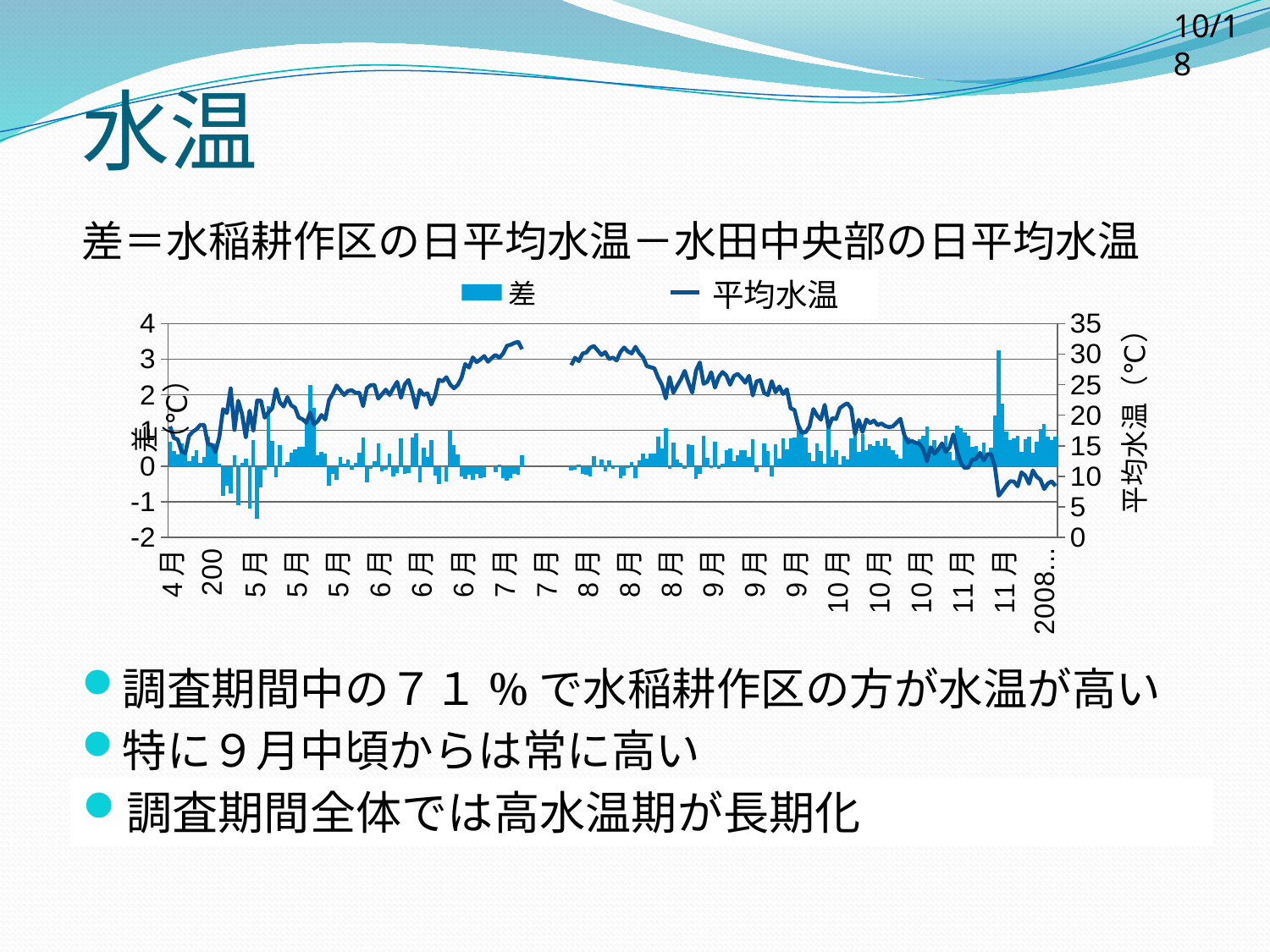
Which series is drawn as bars, 差 or 平均水温? 差 Is the 平均水温 value in 7月 higher or lower than in 11月? higher Does the 平均水温 line rise or fall from 9月 to 11月? fall How many series does the chart legend list? 2 Is the peak of the 平均水温 line in 7月 greater or less than 30? greater Is the 平均水温 line at the end of 11月 greater or less than 10? less What are the two series named in the chart legend? 差 and 平均水温 Is the tallest 差 bar, near 11月, greater or less than 3? greater What is the maximum value shown on the left vertical axis (差)? 4 What is the maximum value shown on the right vertical axis (平均水温)? 35 What kind of chart is shown on the slide? A combined bar and line chart What is the minimum value shown on the left vertical axis? -2